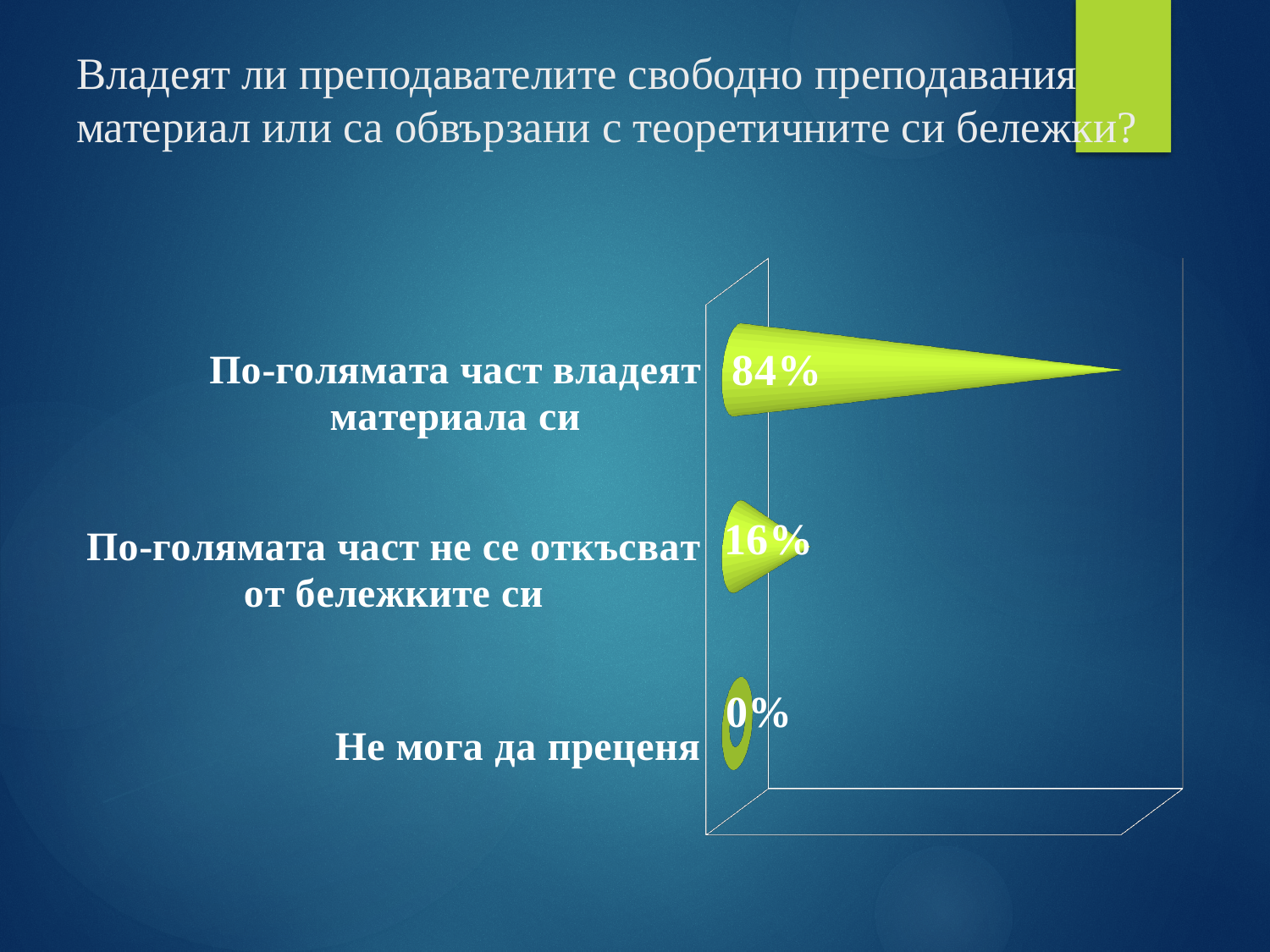
What kind of chart is shown on the slide? Bar chart What colour are the bars in the chart? Green What is the value for "Не мога да преценя"? 0% What question does the slide title ask? Владеят ли преподавателите свободно преподавания материал или са обвързани с теоретичните си бележки? What is the total of the three values shown in the chart? 100% Which category has the highest value? По-голямата част владеят материала си Which is larger: the value for "По-голямата част не се откъсват от бележките си" or the value for "Не мога да преценя"? По-голямата част не се откъсват от бележките си What is the value for "По-голямата част владеят материала си"? 84% What is the value for "По-голямата част не се откъсват от бележките си"? 16% Which category has the lowest value? Не мога да преценя What is the difference between the values for "По-голямата част владеят материала си" and "По-голямата част не се откъсват от бележките си"? 68% How many categories are shown in the chart? 3